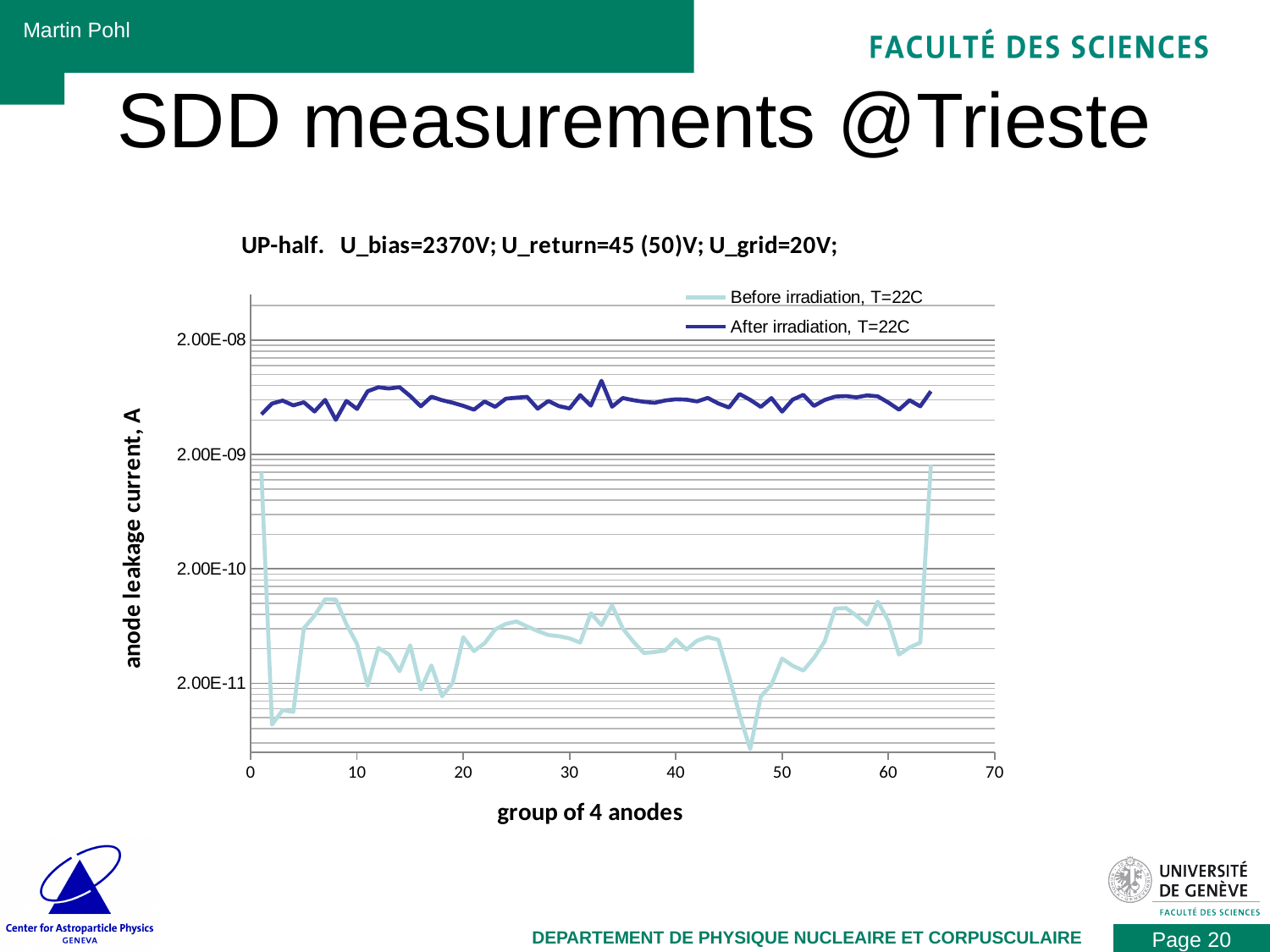
Which series has the higher anode leakage current at group 30: Before irradiation or After irradiation? After irradiation, T=22C Is the After irradiation value at group 20 greater or less than 2.00E-09? greater How many series does the chart's legend list? 2 Which series shows the lower anode leakage current across most of the x axis? Before irradiation, T=22C What are the two series named in the legend? Before irradiation, T=22C; After irradiation, T=22C Is the After irradiation value at group 40 greater or less than 2.00E-08? less Is the Before irradiation value at group 47 greater or less than 2.00E-11? less What kind of chart is shown on the slide? line chart Which series is drawn in dark blue? After irradiation, T=22C What is the label of the y axis? anode leakage current, A